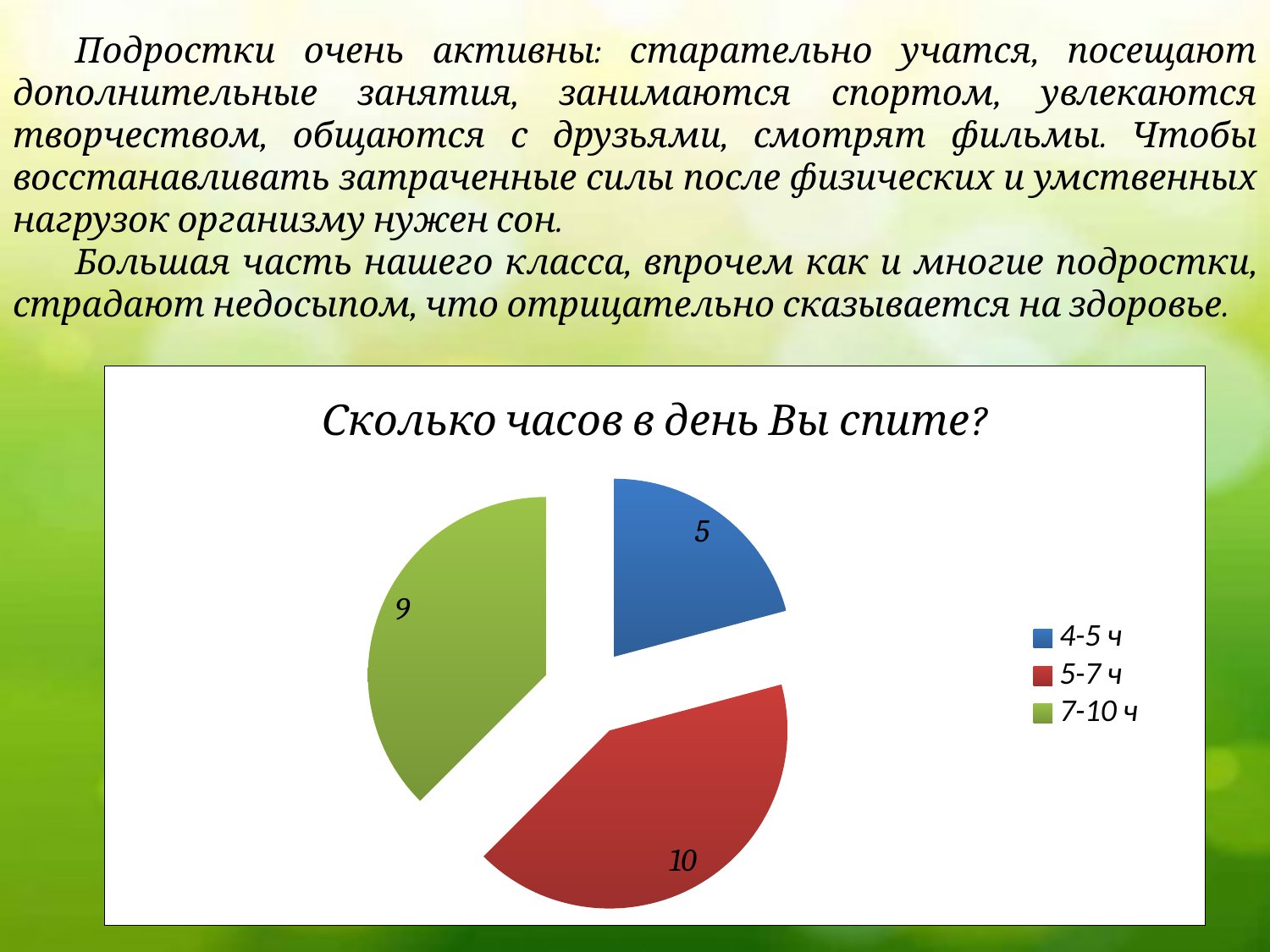
How many slices does the pie chart have? 3 What is the difference between the values for "5-7 ч" and "4-5 ч"? 5 What is the value for the "4-5 ч" slice? 5 What is the value for the "5-7 ч" slice? 10 What is the title of the chart? Сколько часов в день Вы спите? How many entries does the legend list? 3 What type of chart is shown on the slide? pie chart Which category has the largest slice? 5-7 ч Which is larger, the value for "7-10 ч" or the value for "4-5 ч"? 7-10 ч Which category has the smallest slice? 4-5 ч What is the value for the "7-10 ч" slice? 9 What share of the pie does the "7-10 ч" slice represent? 37.5%